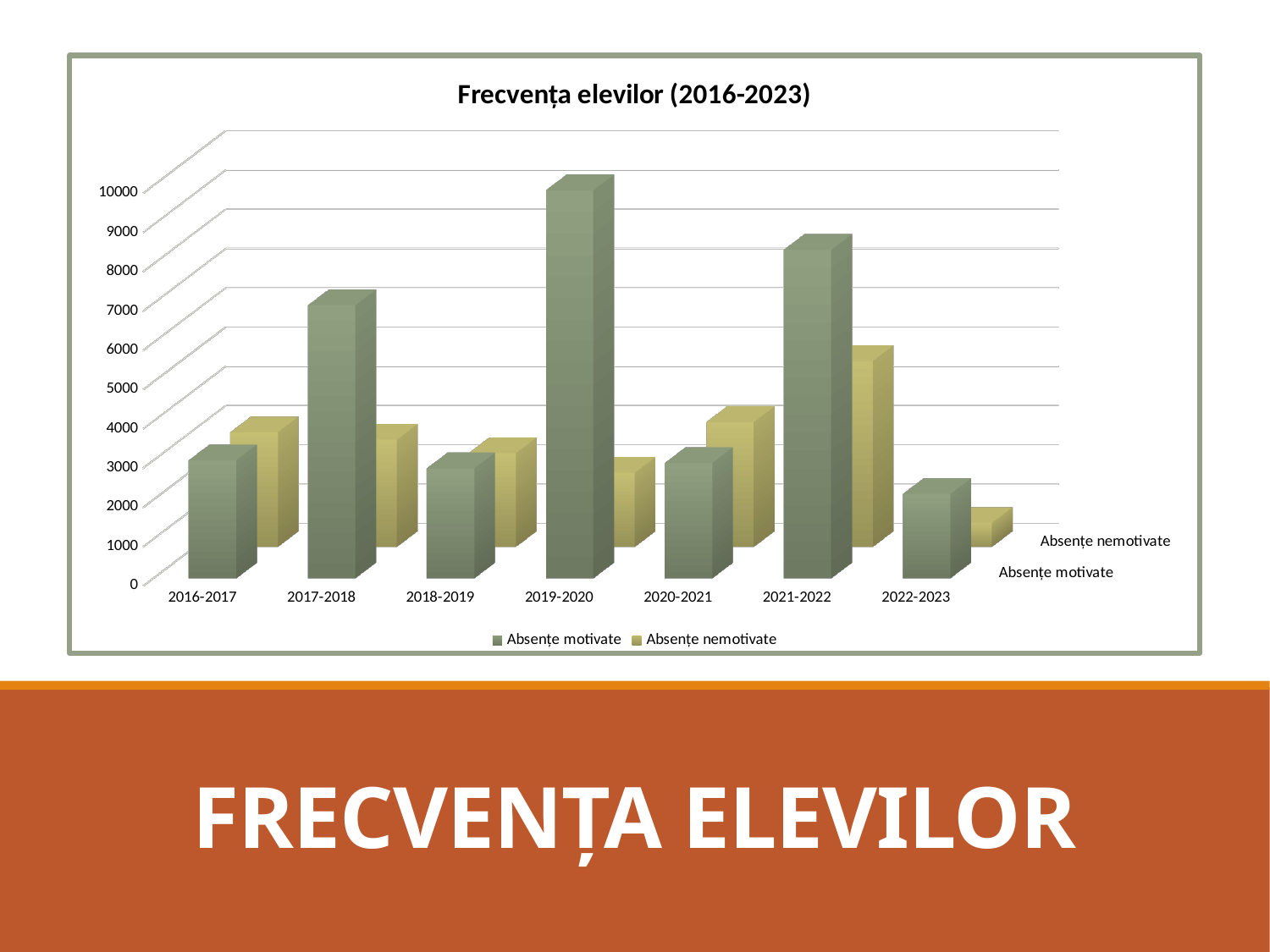
Which school year has the lowest value for Absențe motivate? 2022-2023 Which school year has the highest value for Absențe motivate? 2019-2020 How many series does the legend list? 2 Which school year has the highest value for Absențe nemotivate? 2021-2022 What is the title of the chart? Frecvența elevilor (2016-2023) In 2017-2018, which is larger: Absențe motivate or Absențe nemotivate? Absențe motivate Is the value for Absențe nemotivate in 2022-2023 greater or less than 2000? less What type of chart is shown on the slide? Bar chart Which is larger: Absențe motivate in 2021-2022 or Absențe motivate in 2017-2018? 2021-2022 How many school-year categories are shown on the x axis? 7 Which school year has the lowest value for Absențe nemotivate? 2022-2023 Is the value for Absențe motivate in 2019-2020 greater or less than 8000? greater